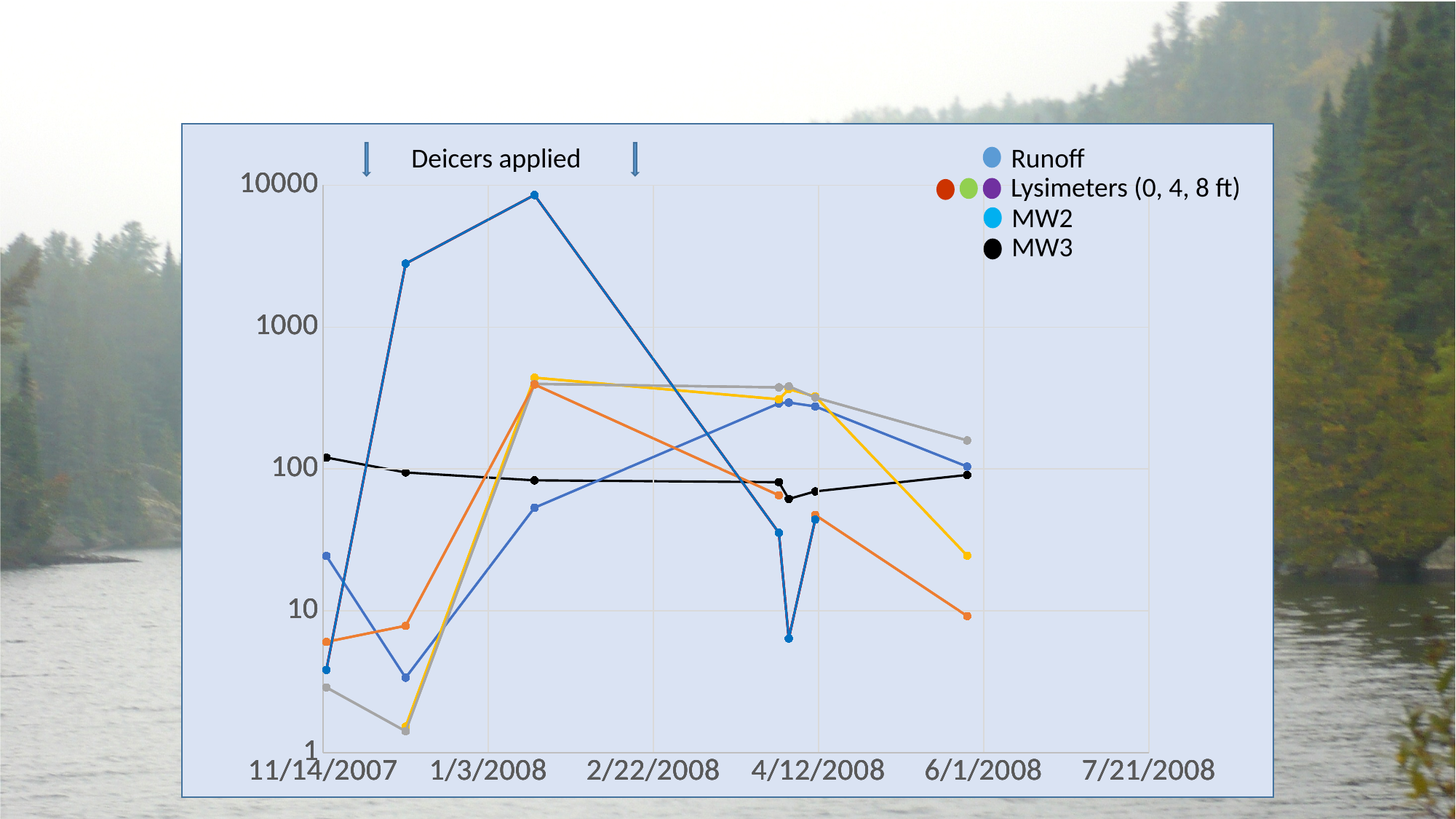
Is the highest plotted value on the chart greater or less than 1000? greater What is the highest tick label on the y axis? 10000 At 11/14/2007, which is higher, the black MW3 line or the orange line? the black MW3 line How many labelled entries does the legend list? 4 How many date labels are shown on the x axis? 6 Is the MW3 value at 1/3/2008 greater or less than 10? greater Is the MW3 value at 11/14/2007 greater or less than 10? greater Does the MW3 line rise or fall from 11/14/2007 to 4/12/2008? fall What annotation text appears at the top of the chart between the two arrows? Deicers applied What kind of chart is shown on the slide? line chart